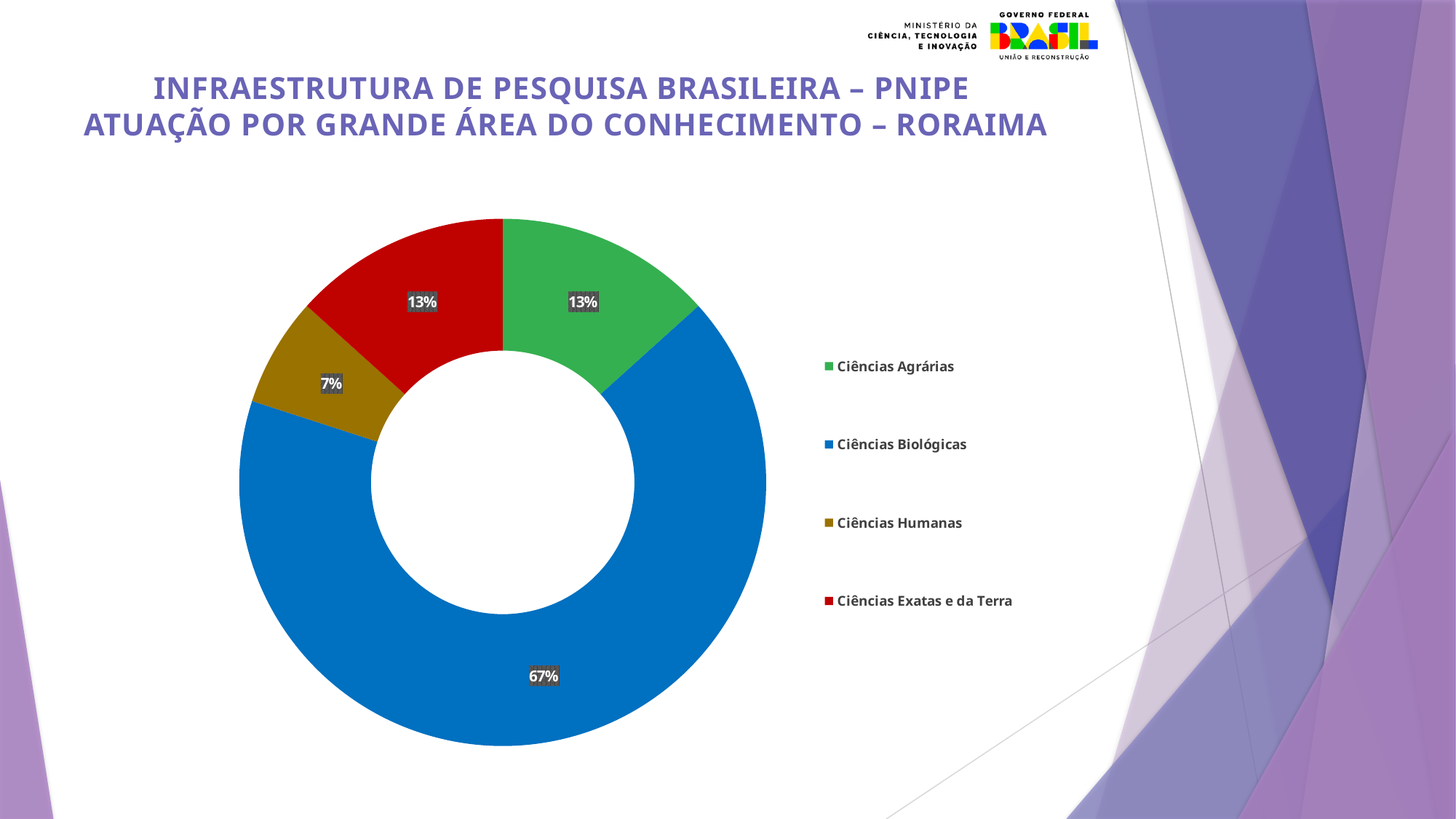
Which colour represents Ciências Exatas e da Terra in the legend? Red What is the value shown for Ciências Exatas e da Terra? 13% Which is larger, the share for Ciências Biológicas or the share for Ciências Exatas e da Terra? Ciências Biológicas What is the value shown for Ciências Agrárias? 13% Which category has the smallest share of the chart? Ciências Humanas What is the difference between the shares of Ciências Agrárias and Ciências Humanas? 6 percentage points How many categories does the chart show? 4 What kind of chart is shown on the slide? Doughnut (pie) chart What share of the chart does Ciências Biológicas represent? 67% Which category has the largest share of the chart? Ciências Biológicas What is the difference between the shares of Ciências Biológicas and Ciências Humanas? 60 percentage points What share of the chart does Ciências Humanas represent? 7%